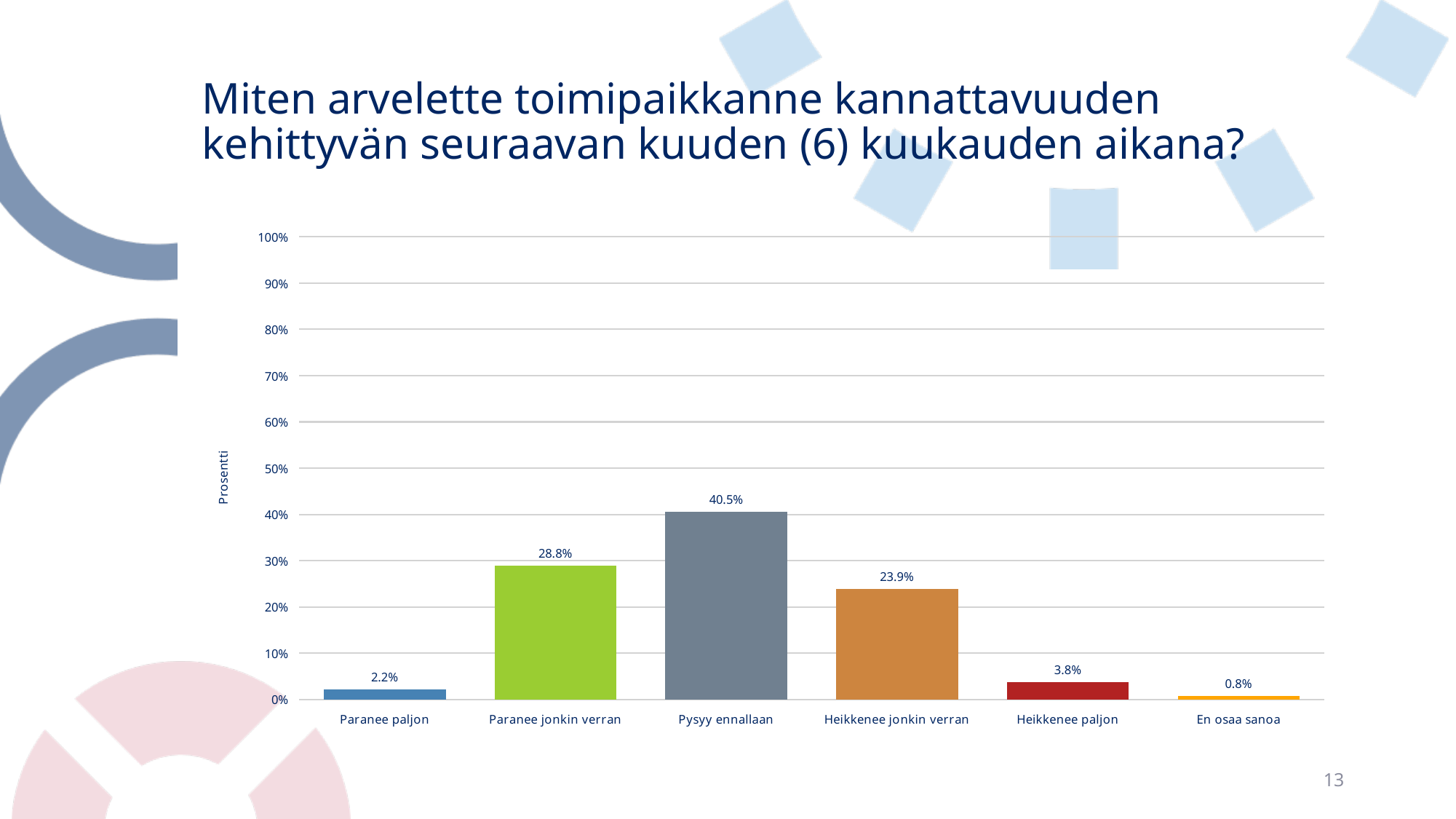
Which category has the lowest value? En osaa sanoa What kind of chart is shown on the slide? bar chart How many categories are shown on the x axis? 6 What is the difference between Pysyy ennallaan and Heikkenee jonkin verran? 16.6% Which is larger, Paranee paljon or Heikkenee paljon? Heikkenee paljon What is the value for Pysyy ennallaan? 40.5% What is the label of the y axis? Prosentti Is the value for Paranee jonkin verran greater or less than 20%? greater What is the value for Heikkenee paljon? 3.8% What is the value for Paranee jonkin verran? 28.8% What is the value for En osaa sanoa? 0.8% Which category has the highest value? Pysyy ennallaan